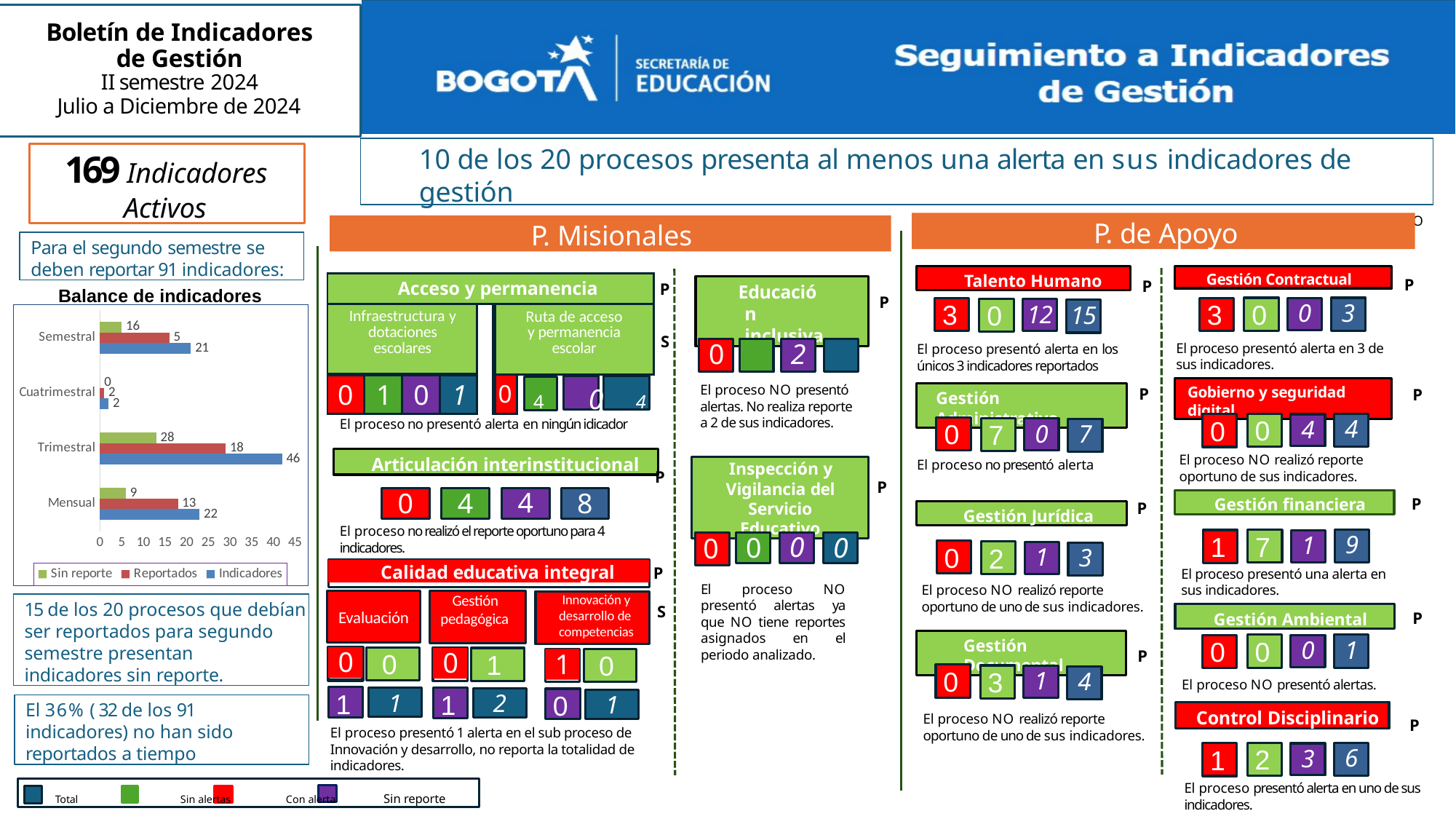
In the 'Balance de indicadores' chart, what is the difference between the Indicadores value and the Reportados value for Trimestral? 28 In the 'Balance de indicadores' chart, which category has the highest Indicadores value? Trimestral What kind of chart is 'Balance de indicadores'? Bar chart In the 'Balance de indicadores' chart, which colour represents the Indicadores series? Blue In the 'Balance de indicadores' chart, what is the Sin reporte value for Semestral? 16 In the 'Balance de indicadores' chart, which is larger for Mensual: Sin reporte or Reportados? Reportados In the 'Balance de indicadores' chart, what is the Indicadores value for Trimestral? 46 In the 'Balance de indicadores' chart, is the Indicadores value for Semestral greater or less than 20? greater In the 'Balance de indicadores' chart, what is the Reportados value for Mensual? 13 How many categories are shown in the 'Balance de indicadores' chart? 4 How many series does the legend of the 'Balance de indicadores' chart list? 3 In the 'Balance de indicadores' chart, which category has the lowest Sin reporte value? Cuatrimestral